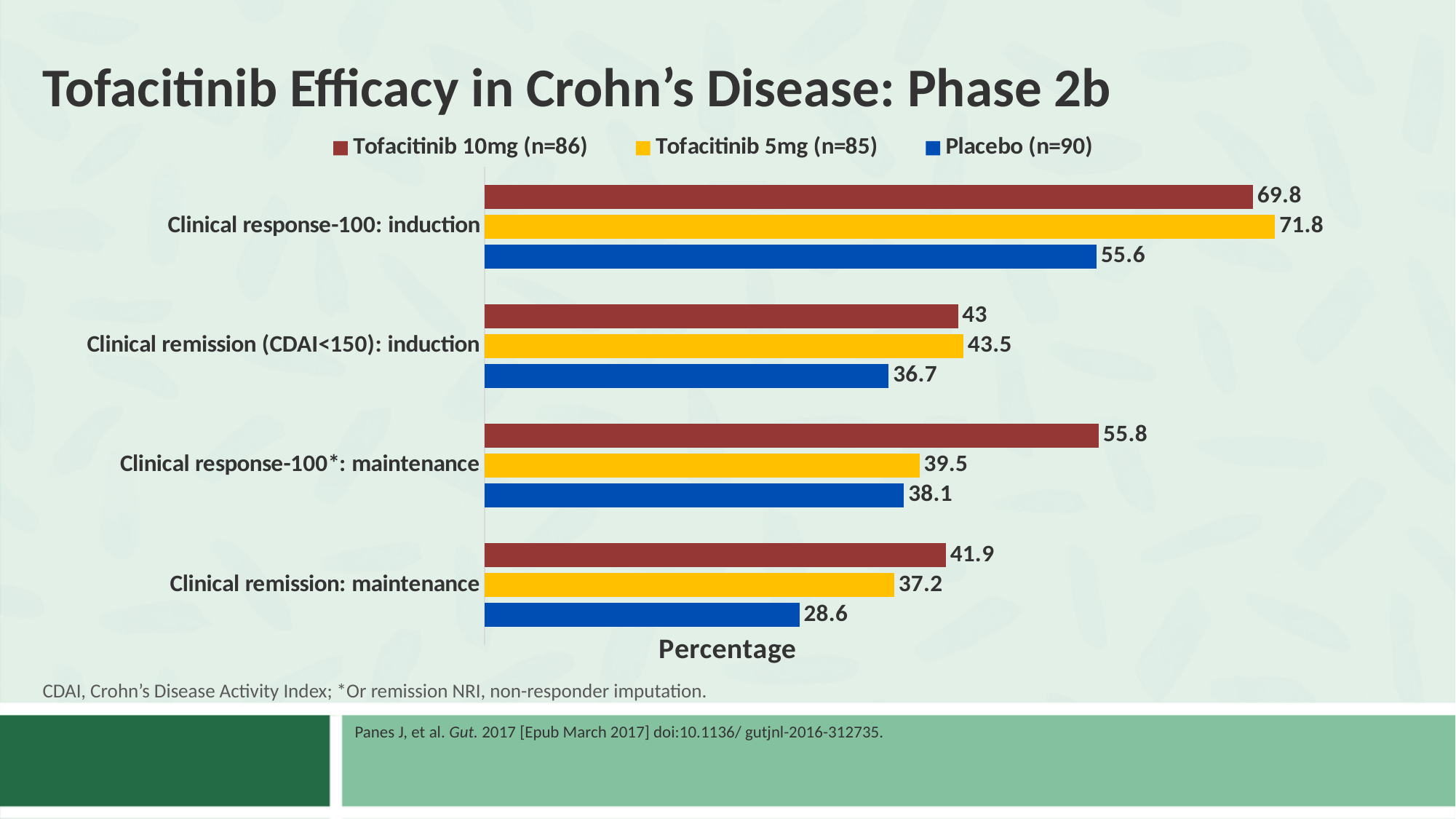
How many categories are shown on the chart? 4 What is the difference between the Tofacitinib 5mg (n=85) and Placebo (n=90) values for Clinical response-100: induction? 16.2 Which category has the lowest Placebo (n=90) value? Clinical remission: maintenance What is the value for Tofacitinib 5mg (n=85) for Clinical response-100*: maintenance? 39.5 What is the difference between the Tofacitinib 10mg (n=86) and Placebo (n=90) values for Clinical response-100*: maintenance? 17.7 Which series has the highest value for Clinical response-100: induction? Tofacitinib 5mg (n=85) What is the label of the horizontal axis? Percentage Which is larger for Clinical remission: maintenance, Tofacitinib 10mg (n=86) or Tofacitinib 5mg (n=85)? Tofacitinib 10mg (n=86) How many series does the legend list? 3 What is the value for Tofacitinib 10mg (n=86) for Clinical response-100: induction? 69.8 What kind of chart is shown on the slide? Bar chart What is the value for Placebo (n=90) for Clinical remission: maintenance? 28.6